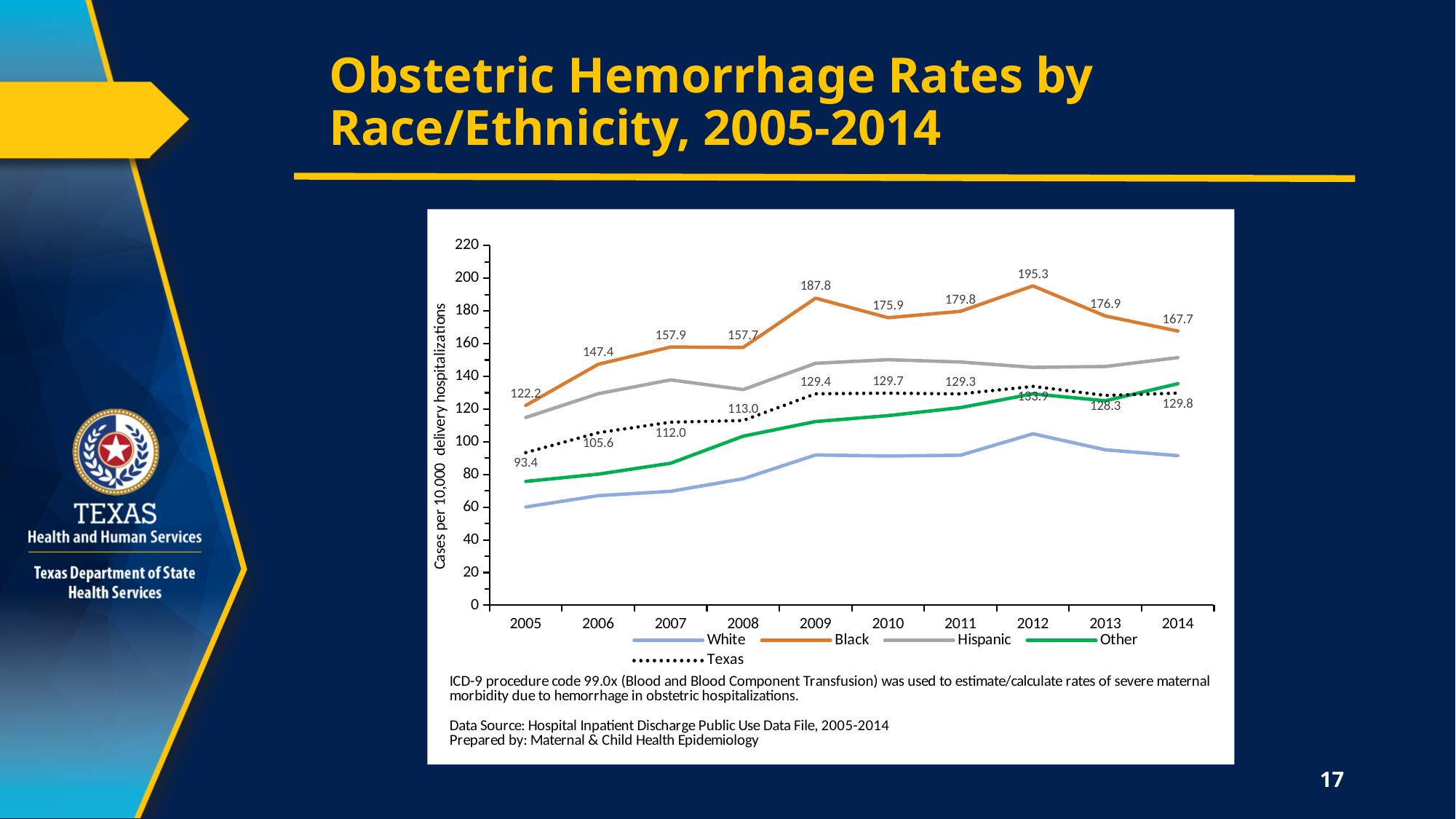
What type of chart is shown on the slide? line chart Which series is drawn as a dotted line? Texas What was the Texas obstetric hemorrhage rate in 2005? 93.4 In which year was the rate for Black women highest? 2012 How many series does the legend list? 5 What is the difference between the Black rate and the Texas rate in 2009? 58.4 Which group had the higher rate in 2010, Black or Texas overall? Black What was the obstetric hemorrhage rate for Black women in 2012? 195.3 How many years are plotted along the x axis? 10 What was the obstetric hemorrhage rate for Black women in 2014? 167.7 Is the value for White women in 2012 greater or less than 120? less In which year was the Texas rate lowest? 2005